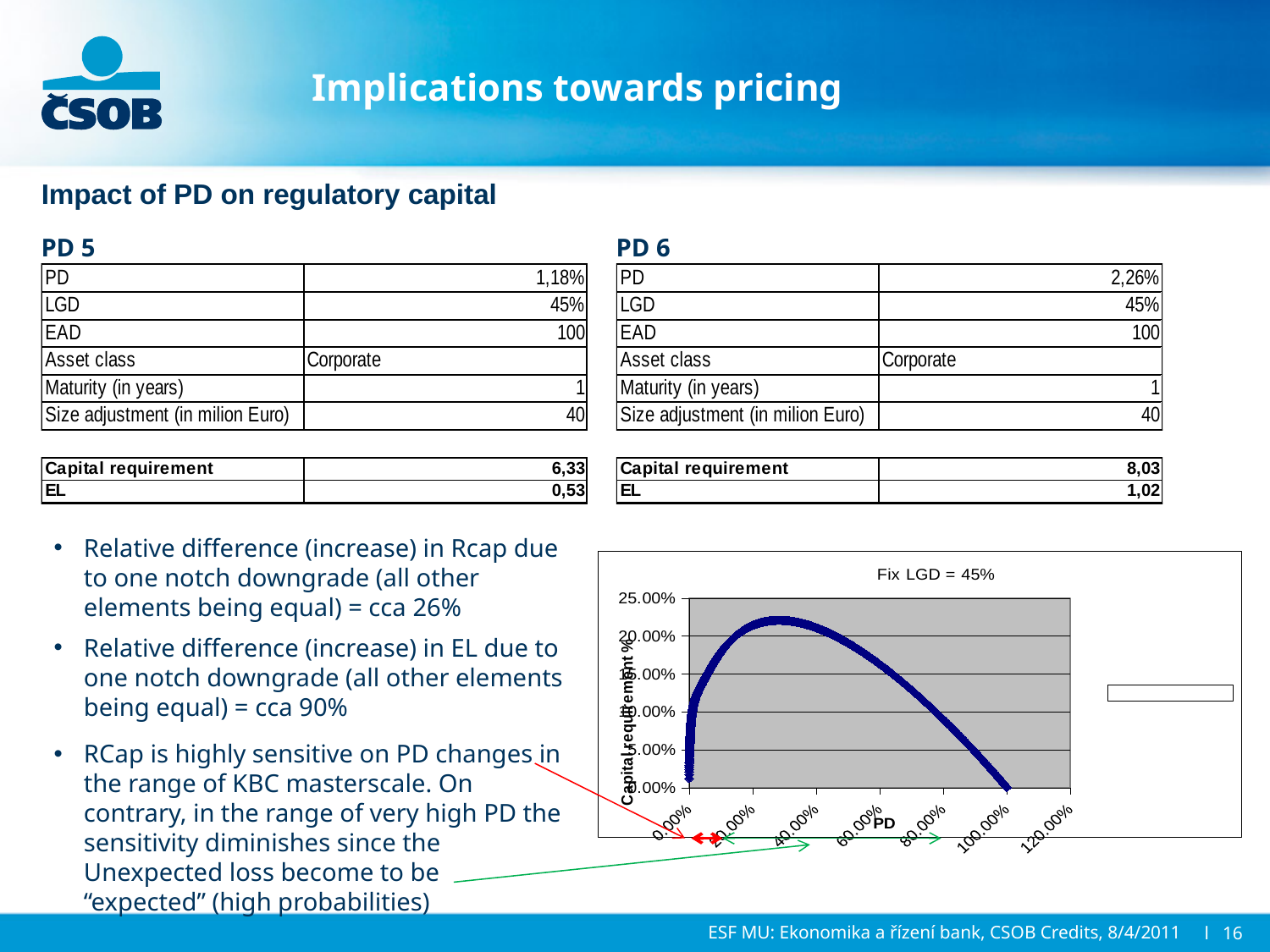
Does the capital requirement rise or fall as PD increases from 0.00% to 20.00%? rise Which is larger: the capital requirement at a PD of 20.00% or at a PD of 80.00%? 20.00% Is the capital requirement at a PD of 20.00% greater or less than 15.00%? greater Is the capital requirement at a PD of 80.00% greater or less than 15.00%? less What is the label of the vertical axis of the chart? Capital requirement % Does the capital requirement rise or fall as PD increases from 60.00% to 100.00%? fall Which is larger: the capital requirement at a PD of 40.00% or at a PD of 100.00%? 40.00% Is the capital requirement at a PD of 60.00% greater or less than 10.00%? greater What is the title of the chart? Fix LGD = 45% What kind of chart is shown on the slide? line chart